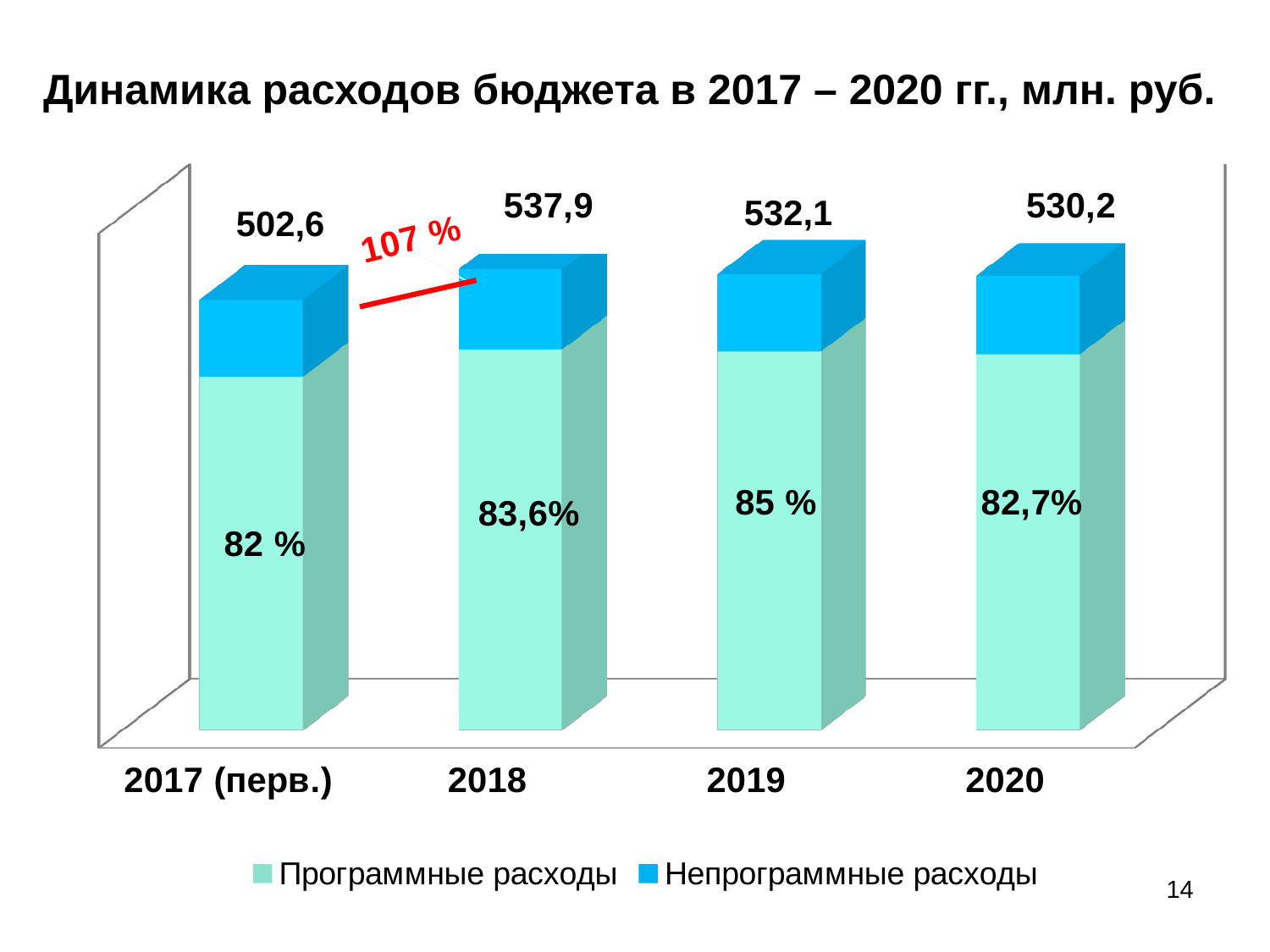
What is the total value labelled above the bar for 2017 (перв.)? 502,6 Which year has the highest share of Программные расходы printed on its bar? 2019 Which year has the lowest total expenditure labelled above its bar? 2017 (перв.) What is the difference between the total labelled for 2018 and the total labelled for 2017 (перв.)? 35,3 How many series does the legend list? 2 Which year has the highest total expenditure labelled above its bar? 2018 What is the total budget expenditure shown above the bar for 2018? 537,9 What kind of chart is shown on the slide? Stacked bar chart How many years (categories) are shown on the x axis? 4 What percentage is printed on the Программные расходы segment for 2020? 82,7% Which is larger, the total labelled for 2019 or the total labelled for 2020? 2019 What percentage is printed on the Программные расходы segment for 2019? 85 %